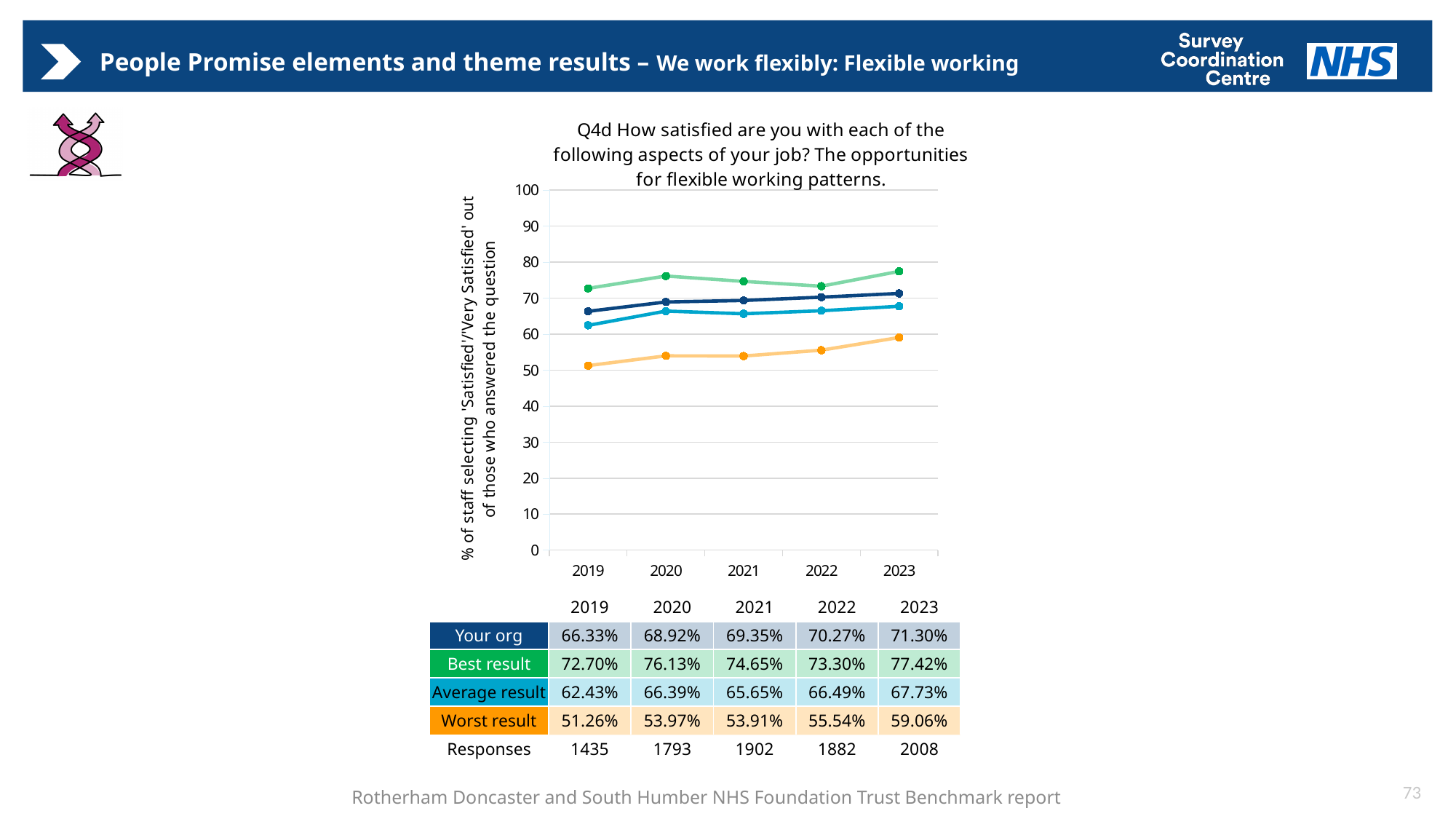
What is the Best result value in 2020? 76.13% Which is larger in 2021: Your org or Average result? Your org In which year is the Your org series lowest? 2019 How many years are plotted on the x axis? 5 In which year is the Best result series highest? 2023 Does the Worst result series rise or fall from 2019 to 2023? Rise What is the difference between Your org and Average result in 2023? 3.57% What is the Worst result value in 2019? 51.26% What is the Average result value in 2022? 66.49% What is the value for Your org in 2023? 71.30% What kind of chart is shown? Line chart How many series are plotted on the chart? 4